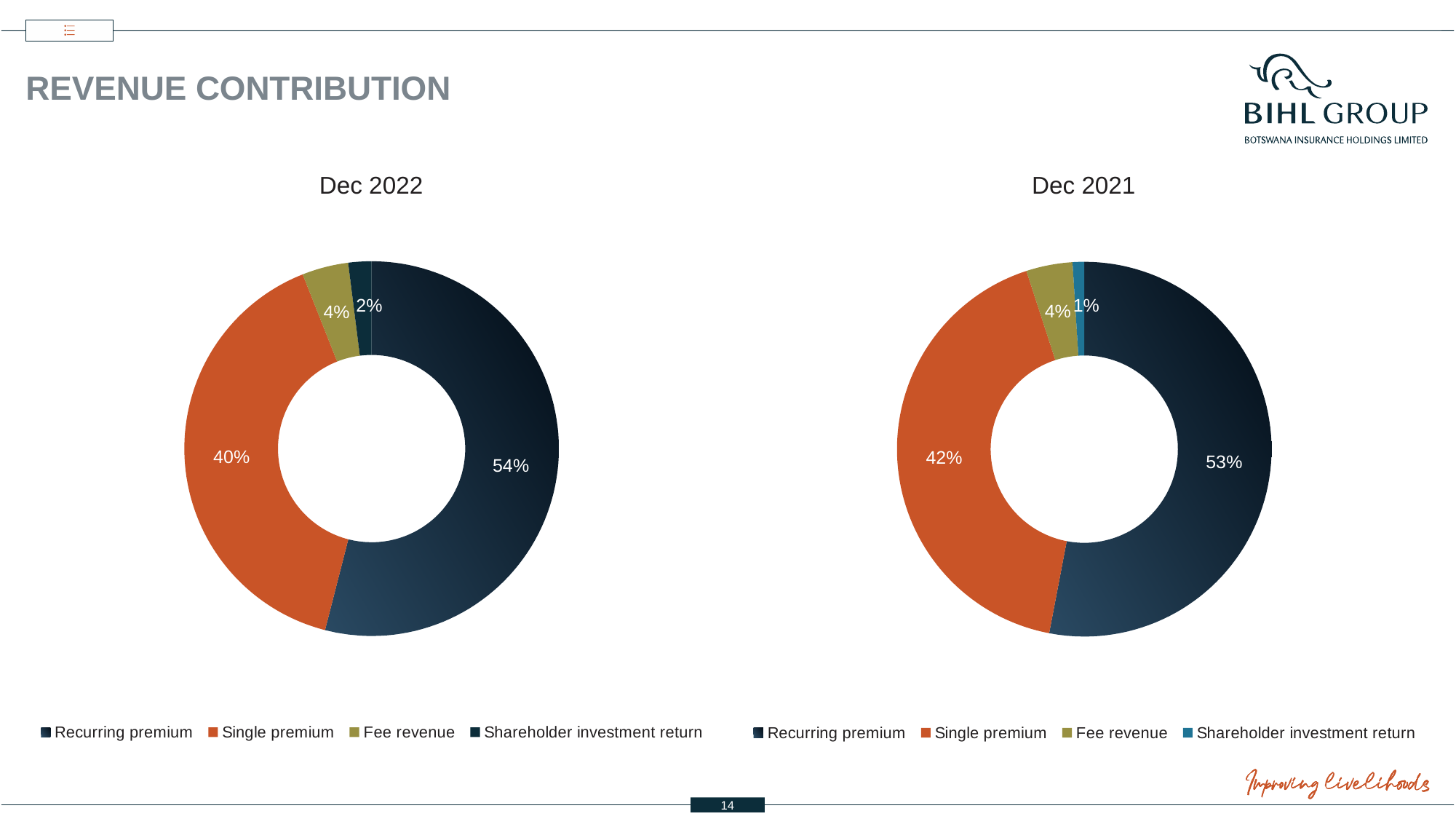
In the Dec 2022 chart, what share of revenue is Single premium? 40% Is the Single premium share larger in the Dec 2022 chart or the Dec 2021 chart? Dec 2021 In the Dec 2021 chart, what share of revenue is Single premium? 42% What is the title of the slide? REVENUE CONTRIBUTION In the Dec 2022 chart, what share of revenue is Recurring premium? 54% In the Dec 2021 chart, what share of revenue is Shareholder investment return? 1% In the Dec 2021 chart, what share of revenue is Fee revenue? 4% What kind of chart is used for Dec 2021? Pie chart (donut) In the Dec 2022 chart, which category has the largest share? Recurring premium How many categories does the legend of the Dec 2022 chart list? 4 In the Dec 2021 chart, which category has the smallest share? Shareholder investment return In the Dec 2022 chart, what is the difference in percentage points between Recurring premium and Single premium? 14